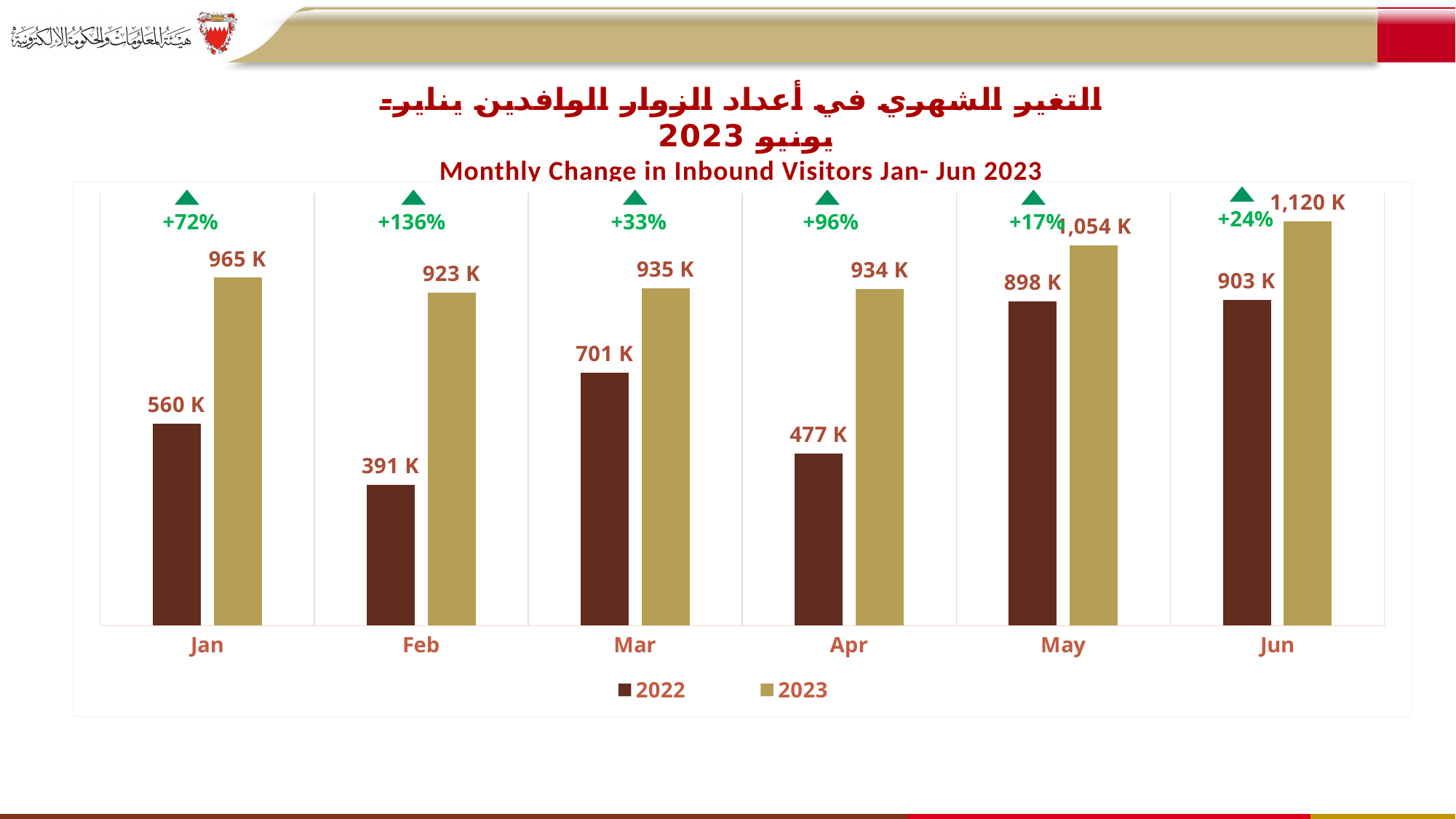
What kind of chart is shown? Bar chart Which month has the highest 2023 value? Jun Which is larger, the 2022 value in Mar or the 2022 value in Apr? Mar What is the value for 2022 in Feb? 391 K Which month has the lowest 2022 value? Feb What is the value for 2023 in Jun? 1,120 K What is the value for 2022 in May? 898 K What is the difference between the 2023 and 2022 values in Jan? 405 K How many series does the legend list? 2 What percentage change is shown above the Feb bars? +136% How many months are shown on the x axis? 6 What is the English title of the chart? Monthly Change in Inbound Visitors Jan- Jun 2023